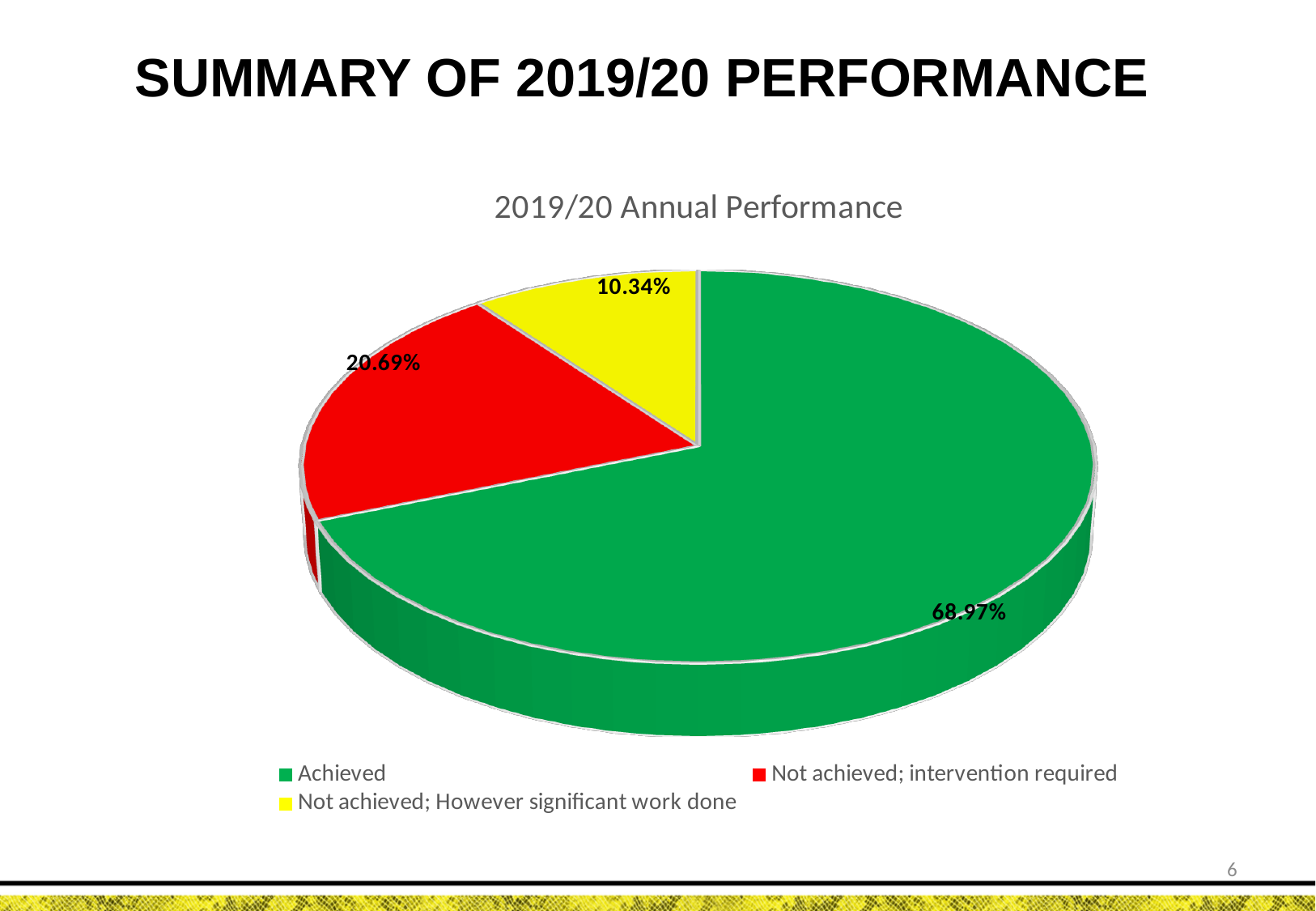
What is the chart's title? 2019/20 Annual Performance Which category has the smallest share of the pie? Not achieved; However significant work done What percentage of the pie is labelled 'Achieved'? 68.97% What type of chart is shown on the slide? Pie chart What percentage is shown for 'Not achieved; However significant work done'? 10.34% What is the difference in percentage points between 'Achieved' and 'Not achieved; intervention required'? 48.28 Which is larger: the share for 'Not achieved; intervention required' or 'Not achieved; However significant work done'? Not achieved; intervention required Which category has the largest share of the pie? Achieved How many entries does the legend list? 3 What percentage is shown for 'Not achieved; intervention required'? 20.69% How many slices does the pie chart have? 3 What colour represents the 'Achieved' slice? Green